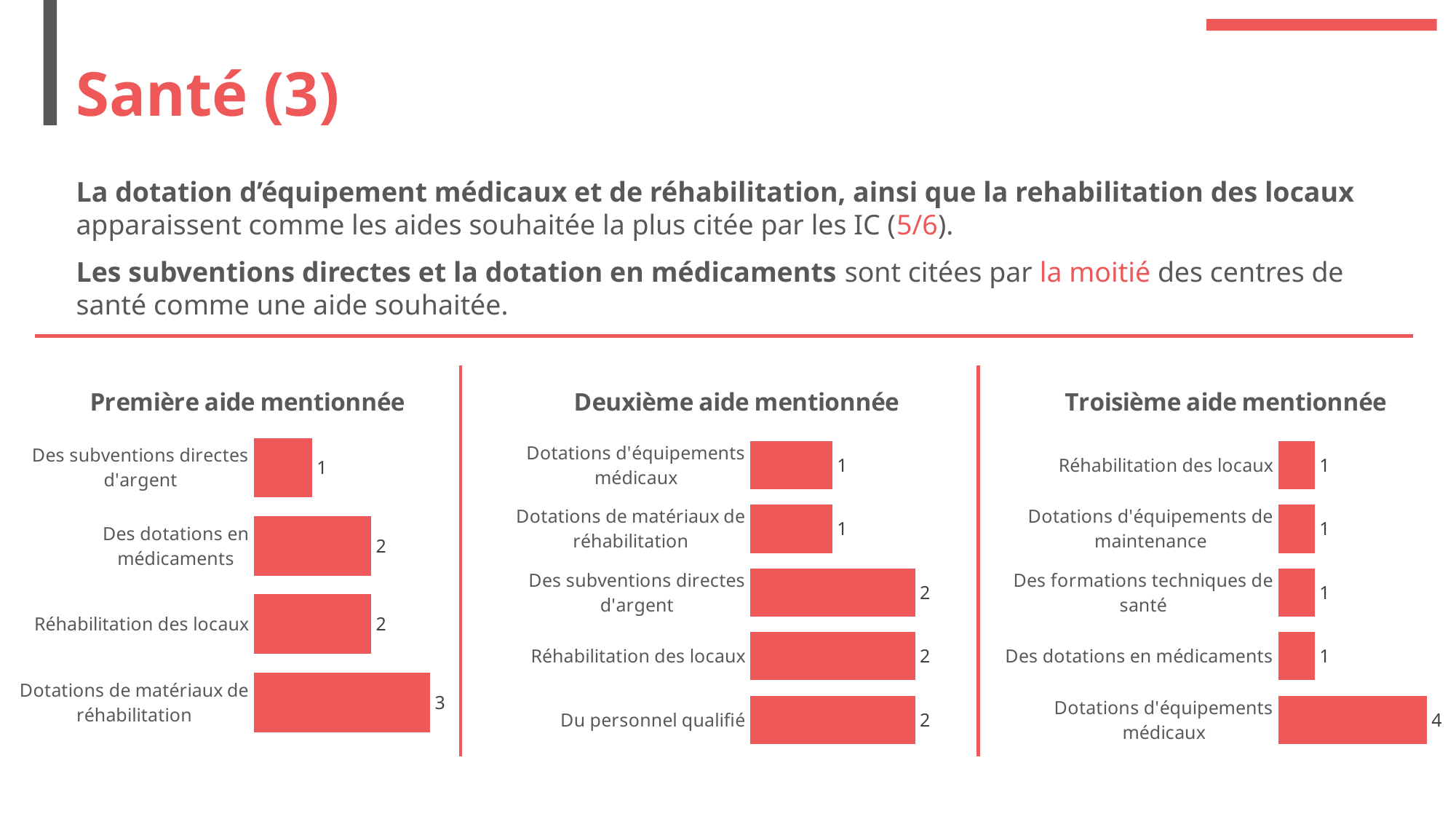
In the 'Deuxième aide mentionnée' chart, how many categories are shown? 5 How many charts are shown on the slide? 3 In the 'Première aide mentionnée' chart, what is the value for 'Dotations de matériaux de réhabilitation'? 3 In the 'Deuxième aide mentionnée' chart, which is larger: 'Réhabilitation des locaux' or 'Dotations d'équipements médicaux'? Réhabilitation des locaux In the 'Troisième aide mentionnée' chart, which category has the highest value? Dotations d'équipements médicaux In the 'Troisième aide mentionnée' chart, what is the difference between 'Dotations d'équipements médicaux' and 'Réhabilitation des locaux'? 3 In the 'Première aide mentionnée' chart, how many categories are shown? 4 In the 'Première aide mentionnée' chart, what is the difference between 'Dotations de matériaux de réhabilitation' and 'Des subventions directes d'argent'? 2 What type of chart is the 'Troisième aide mentionnée' chart? Bar chart In the 'Deuxième aide mentionnée' chart, what is the value for 'Du personnel qualifié'? 2 In the 'Première aide mentionnée' chart, which category has the lowest value? Des subventions directes d'argent In the 'Troisième aide mentionnée' chart, what is the value for 'Des formations techniques de santé'? 1